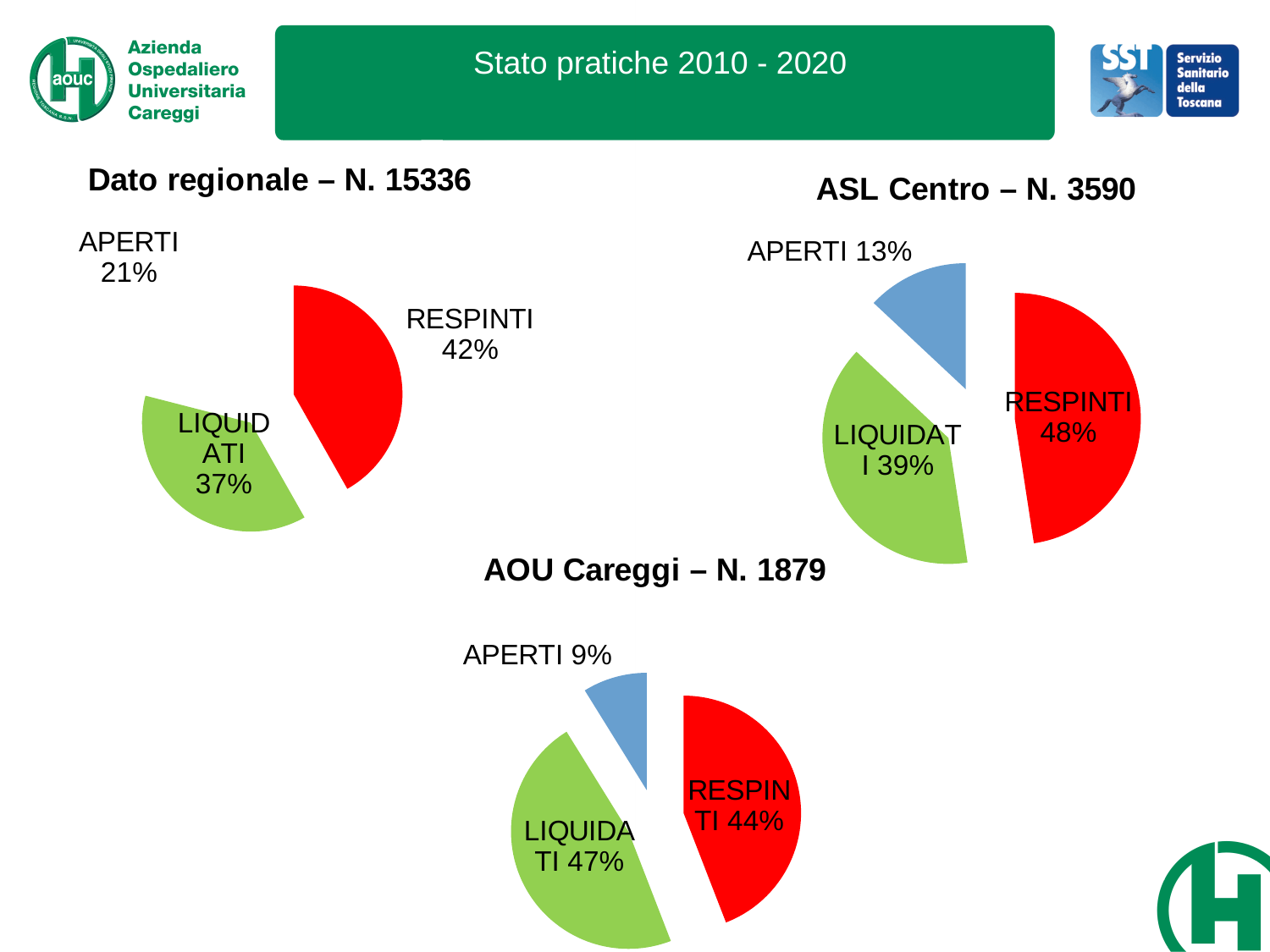
How many pie charts are shown on the slide? 3 In the 'ASL Centro – N. 3590' chart, what is the difference in percentage points between RESPINTI and APERTI? 35 percentage points In the 'AOU Careggi – N. 1879' chart, what share is LIQUIDATI? 47% In the 'Dato regionale – N. 15336' chart, what share is RESPINTI? 42% What type of chart is used for 'ASL Centro – N. 3590'? Pie chart In the 'Dato regionale – N. 15336' chart, what is the difference in percentage points between RESPINTI and LIQUIDATI? 5 percentage points In the 'AOU Careggi – N. 1879' chart, which category has the smallest share? APERTI In the 'AOU Careggi – N. 1879' chart, which is larger, LIQUIDATI or RESPINTI? LIQUIDATI In the 'ASL Centro – N. 3590' chart, which category has the largest share? RESPINTI In the 'Dato regionale – N. 15336' chart, what share is LIQUIDATI? 37% How many slices does the 'AOU Careggi – N. 1879' chart have? 3